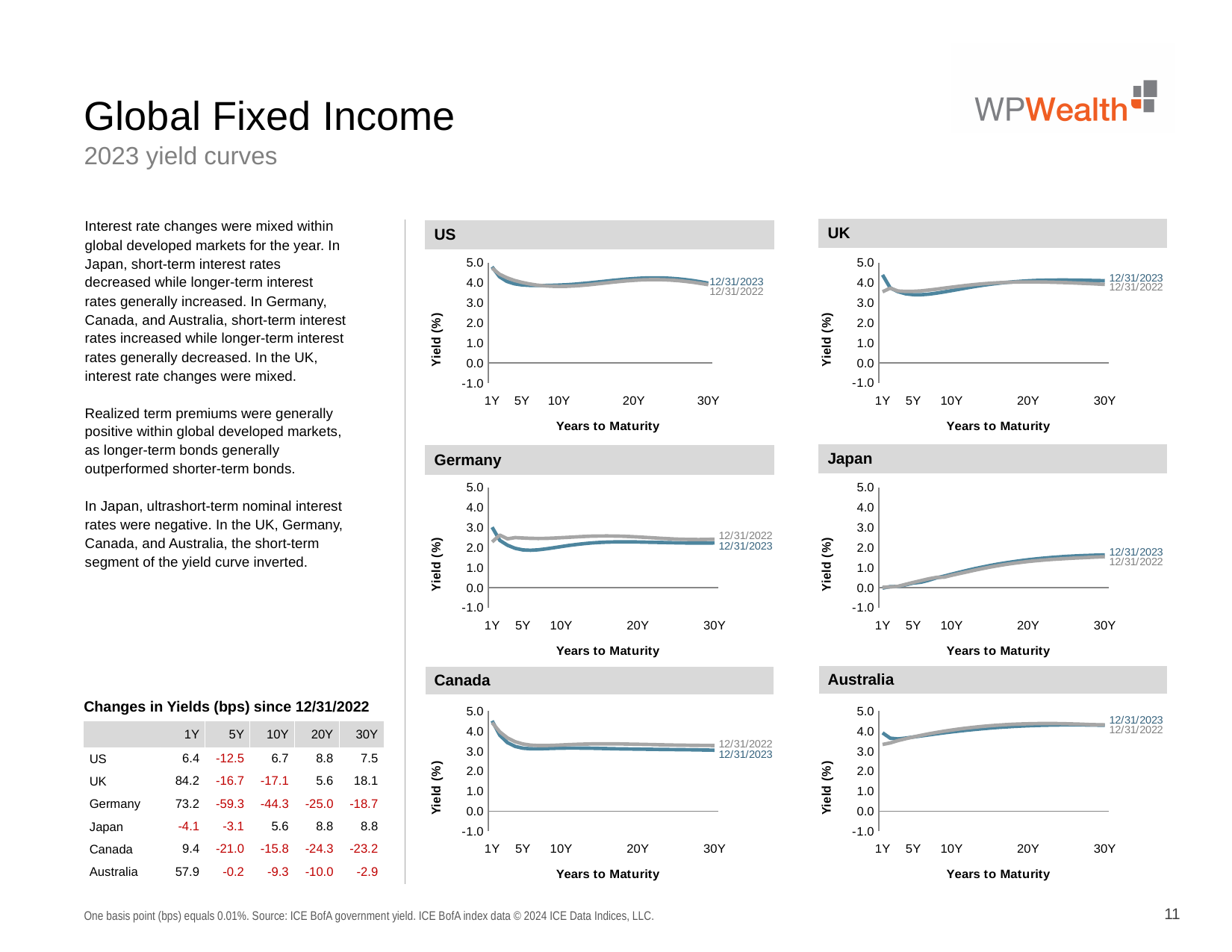
What is the y-axis label on the Canada chart? Yield (%) In the Japan chart, how many series are plotted? 2 How many yield curve charts are shown on the slide? 6 In the Germany chart, what are the two series labels? 12/31/2022 and 12/31/2023 In the Germany chart, is the 12/31/2023 value at 5Y greater or less than 3.0? less In the Japan chart, do the 12/31/2023 yields rise or fall as years to maturity increase? rise In the Japan chart, is the 12/31/2023 value at 30Y greater or less than 1.0? greater What kind of chart is the US chart? line chart In the Japan chart, which is larger for 12/31/2023: the yield at 1Y or at 30Y? 30Y In the Australia chart, is the 12/31/2022 value at 1Y greater or less than 4.0? less In the US chart, which is larger for 12/31/2023: the yield at 1Y or at 10Y? 1Y